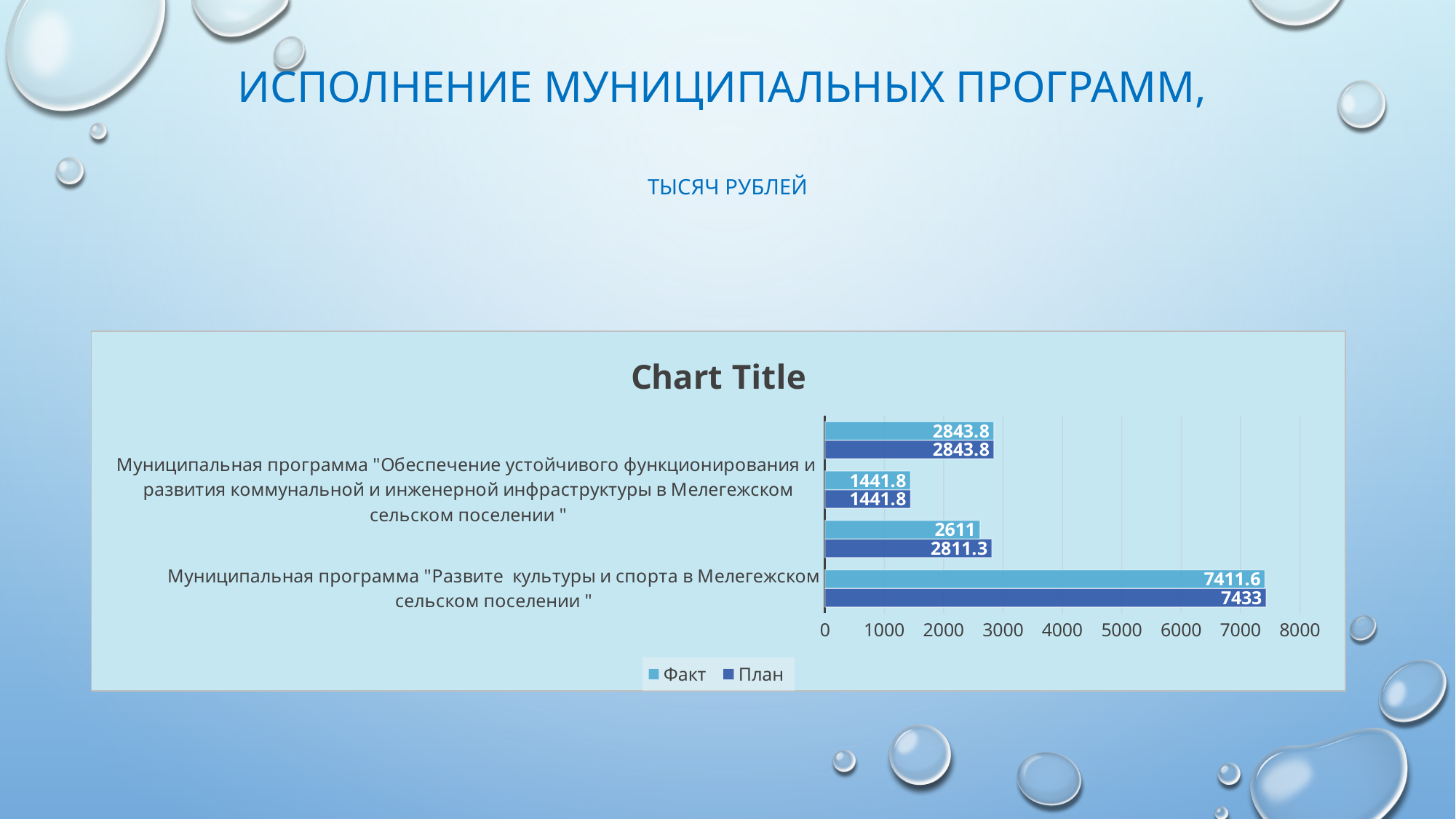
How many series does the chart legend list? 2 In the bottom group of bars, what is the difference between the План value and the Факт value? 21.4 How many groups of bars are plotted in the chart? 4 What are the two series named in the chart legend? Факт and План What is the Факт value for the topmost group of bars? 2843.8 In the third group of bars from the top, which is larger, Факт or План? План What kind of chart is shown on the slide? bar chart Is the Факт value for the bottom group of bars greater or less than 7000? greater What is the highest Факт value shown in the chart? 7411.6 In the third group of bars from the top, what is the difference between the План value (2811.3) and the Факт value (2611)? 200.3 What is the lowest План value shown in the chart? 1441.8 What is the План value for the bottom group of bars? 7433